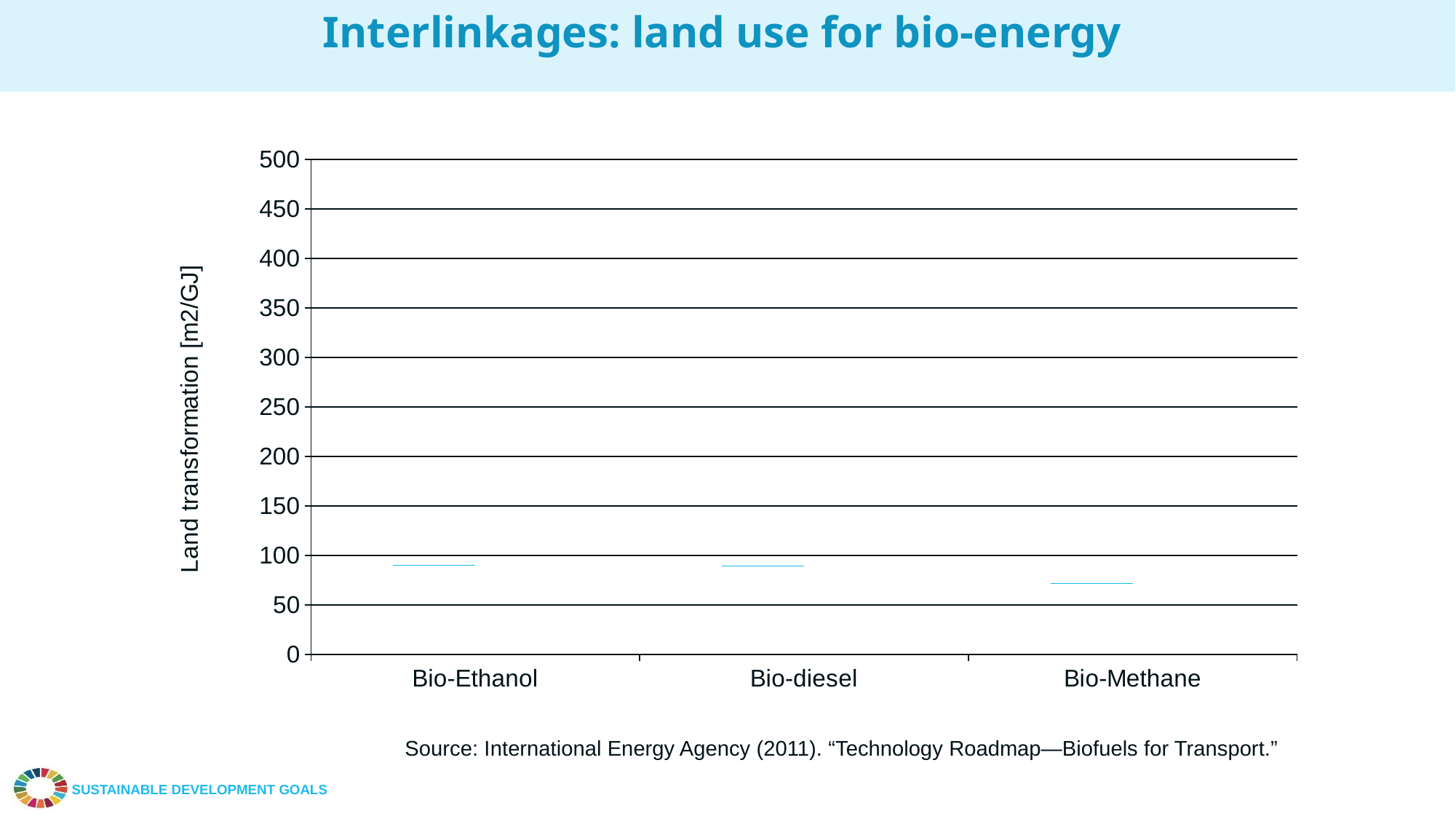
Which is larger, the value for Bio-diesel or the value for Bio-Methane? Bio-diesel Which is larger, the value for Bio-Ethanol or the value for Bio-Methane? Bio-Ethanol Is the value for Bio-Ethanol greater or less than 50? greater How many categories are shown on the x axis of the chart? 3 Is the value for Bio-Methane greater or less than 50? greater Is the value for Bio-diesel greater or less than 150? less What is the label of the vertical axis of the chart? Land transformation [m2/GJ] What is the maximum value shown on the vertical axis of the chart? 500 Which category has the lowest land transformation value? Bio-Methane